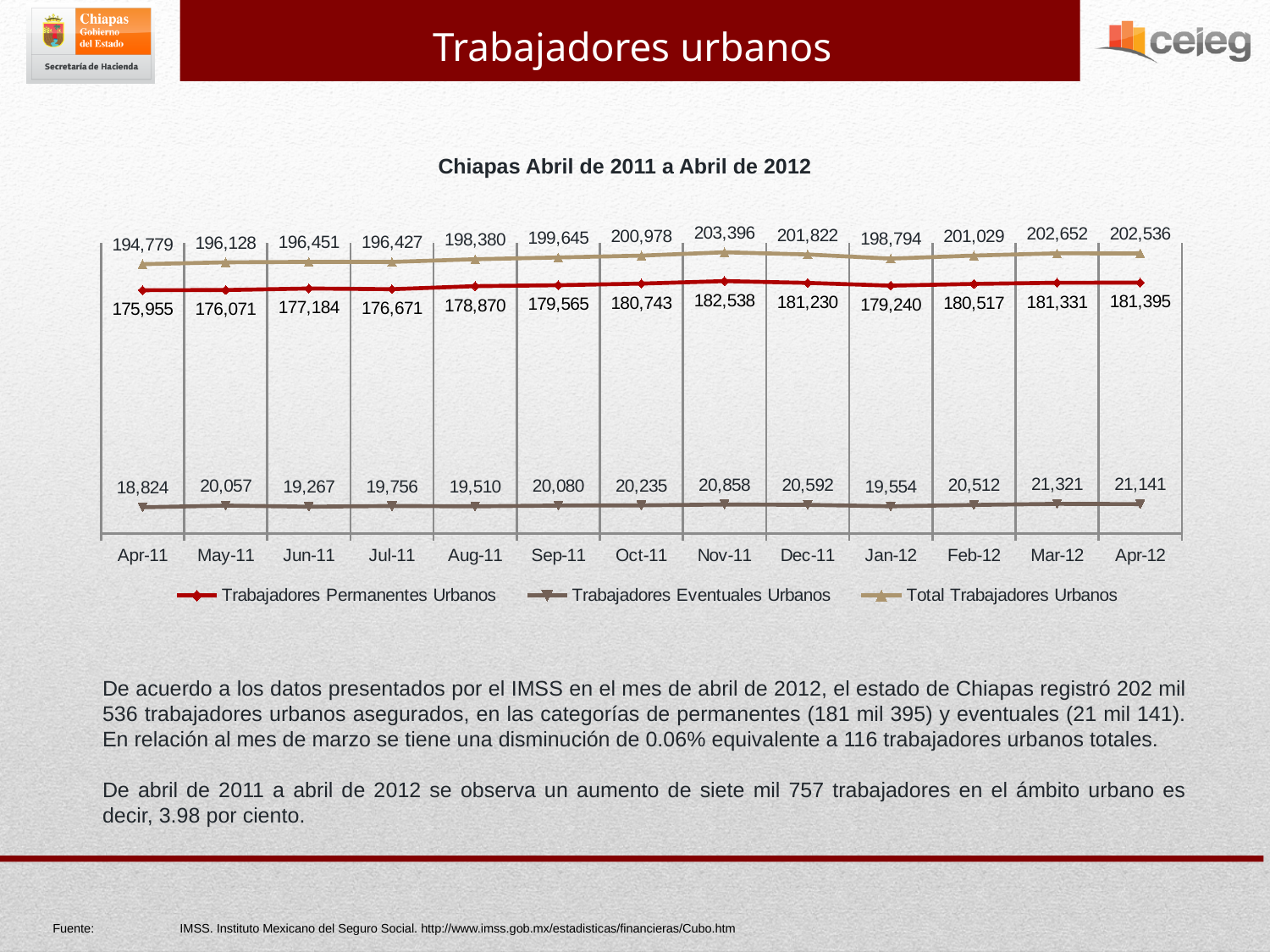
What is the value of Trabajadores Eventuales Urbanos for Jan-12? 19,554 What is the difference between Trabajadores Permanentes Urbanos in Nov-11 and Oct-11? 1,795 What kind of chart is shown on the slide? Line chart In which month is Total Trabajadores Urbanos highest? Nov-11 What is the value of Total Trabajadores Urbanos for Nov-11? 203,396 How many months are plotted on the x axis? 13 In which month is Trabajadores Eventuales Urbanos lowest? Apr-11 Which is larger, Total Trabajadores Urbanos in Jan-12 or in Feb-12? Feb-12 How many series does the legend list? 3 What is the difference between Total Trabajadores Urbanos in Apr-12 and Apr-11? 7,757 What is the value of Trabajadores Permanentes Urbanos for Apr-12? 181,395 In which month is Trabajadores Eventuales Urbanos highest? Mar-12